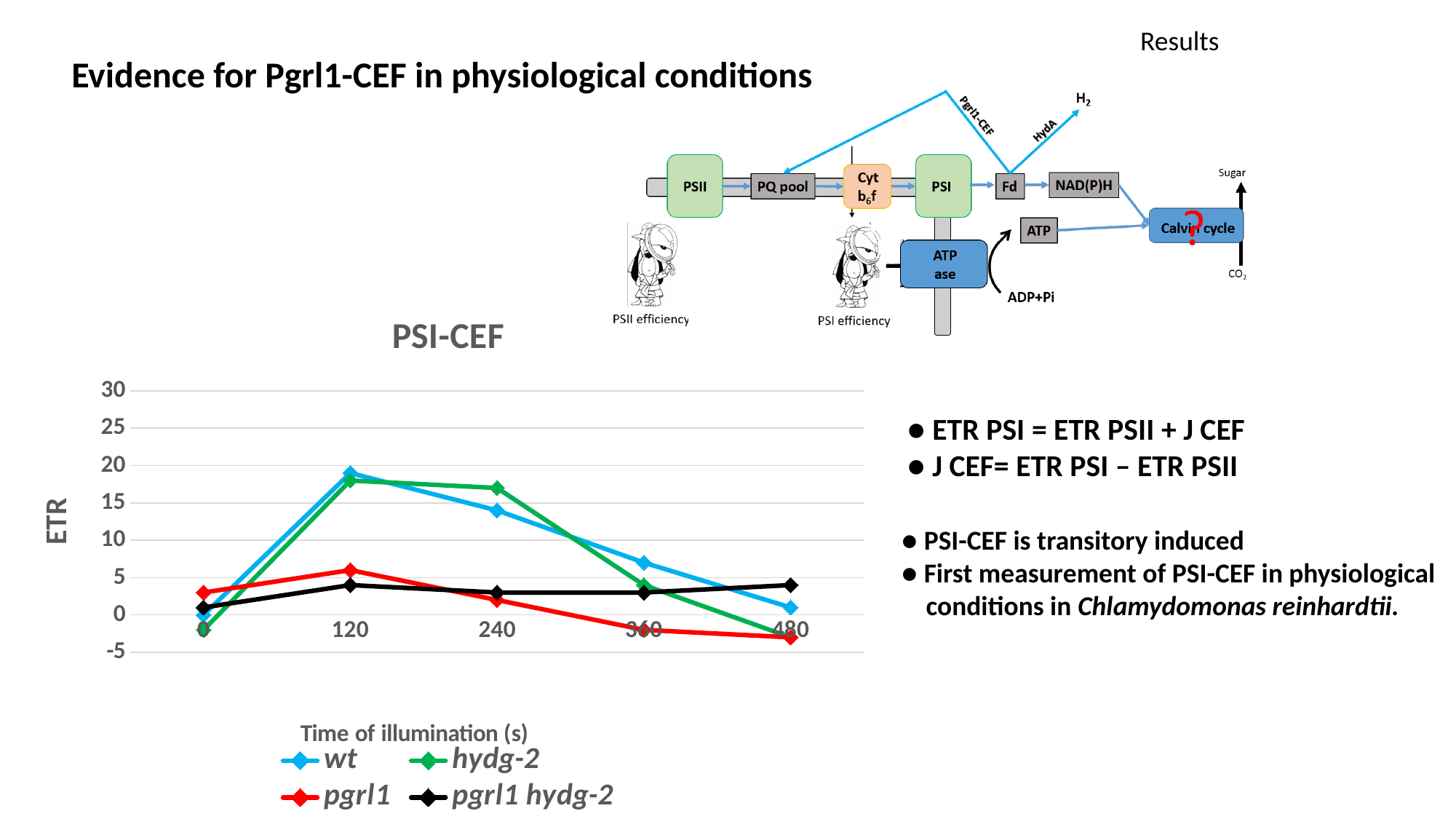
What is the label on the y axis of the PSI-CEF chart? ETR In the PSI-CEF chart, at which time of illumination does pgrl1 reach its highest ETR? 120 How many series does the legend of the PSI-CEF chart list? 4 In the PSI-CEF chart, is the ETR value for wt at 120 s greater or less than 15? greater In the PSI-CEF chart, does the ETR for wt rise or fall from 120 s to 480 s? fall In the PSI-CEF chart, is the ETR value for hydg-2 at 240 s greater or less than 10? greater In the PSI-CEF chart, which series has the highest ETR at 360 s? wt What kind of chart is the PSI-CEF chart? line chart In the PSI-CEF chart, is the ETR value for pgrl1 at 480 s greater or less than 0? less In the PSI-CEF chart, which series has the higher ETR at 240 s, wt or hydg-2? hydg-2 How many time points are plotted for each series in the PSI-CEF chart? 5 In the PSI-CEF chart, which series has the higher ETR at 120 s, wt or pgrl1? wt